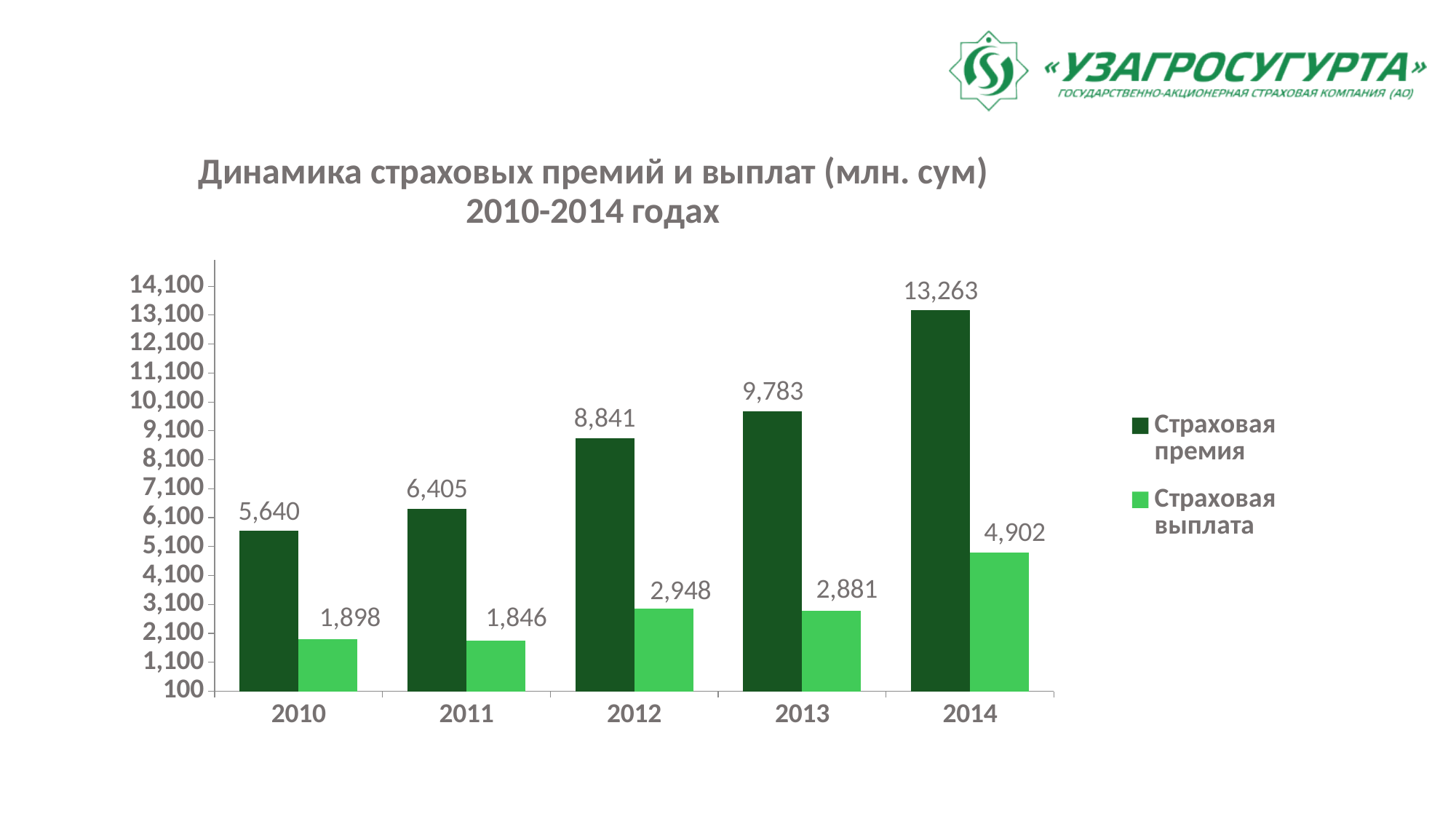
By how much did Страховая премия increase from 2012 to 2013? 942 What is the value of Страховая премия for 2014? 13,263 In which year is Страховая выплата the lowest? 2011 How many years are shown on the x axis? 5 Is the value of Страховая премия for 2013 greater or less than 10,100? less How many series does the legend list? 2 What is the value of Страховая выплата for 2012? 2,948 Which is larger: Страховая выплата in 2012 or in 2013? 2012 What is the value of Страховая премия for 2010? 5,640 In which year is Страховая премия the highest? 2014 Does Страховая премия rise or fall from 2010 to 2014? rise What is the difference between Страховая премия and Страховая выплата in 2014? 8,361